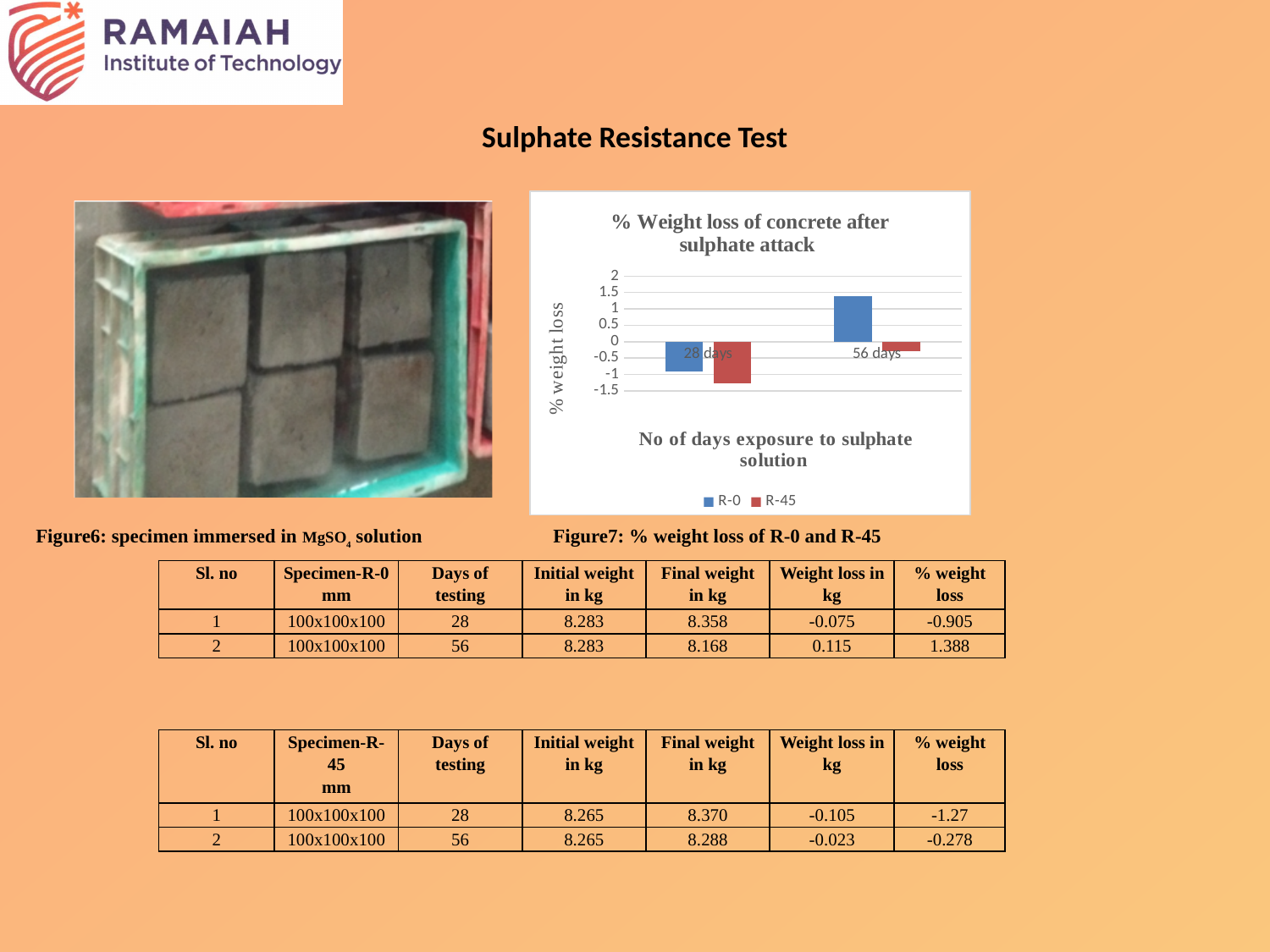
How many categories are shown on the x axis of the chart? 2 Is the value for R-45 at 28 days greater or less than -1? less Is the value for R-45 at 56 days greater or less than -0.5? greater What is the label of the chart's vertical axis? % weight loss Does the value for R-0 rise or fall from 28 days to 56 days? rise At 56 days, which series has the larger value, R-0 or R-45? R-0 Is the value for R-0 at 56 days greater or less than 1? greater Which series and category has the highest bar in the chart? R-0 at 56 days How many series does the chart legend list? 2 What kind of chart is shown on the slide? bar chart What is the title of the chart? % Weight loss of concrete after sulphate attack Which series and category has the lowest bar in the chart? R-45 at 28 days